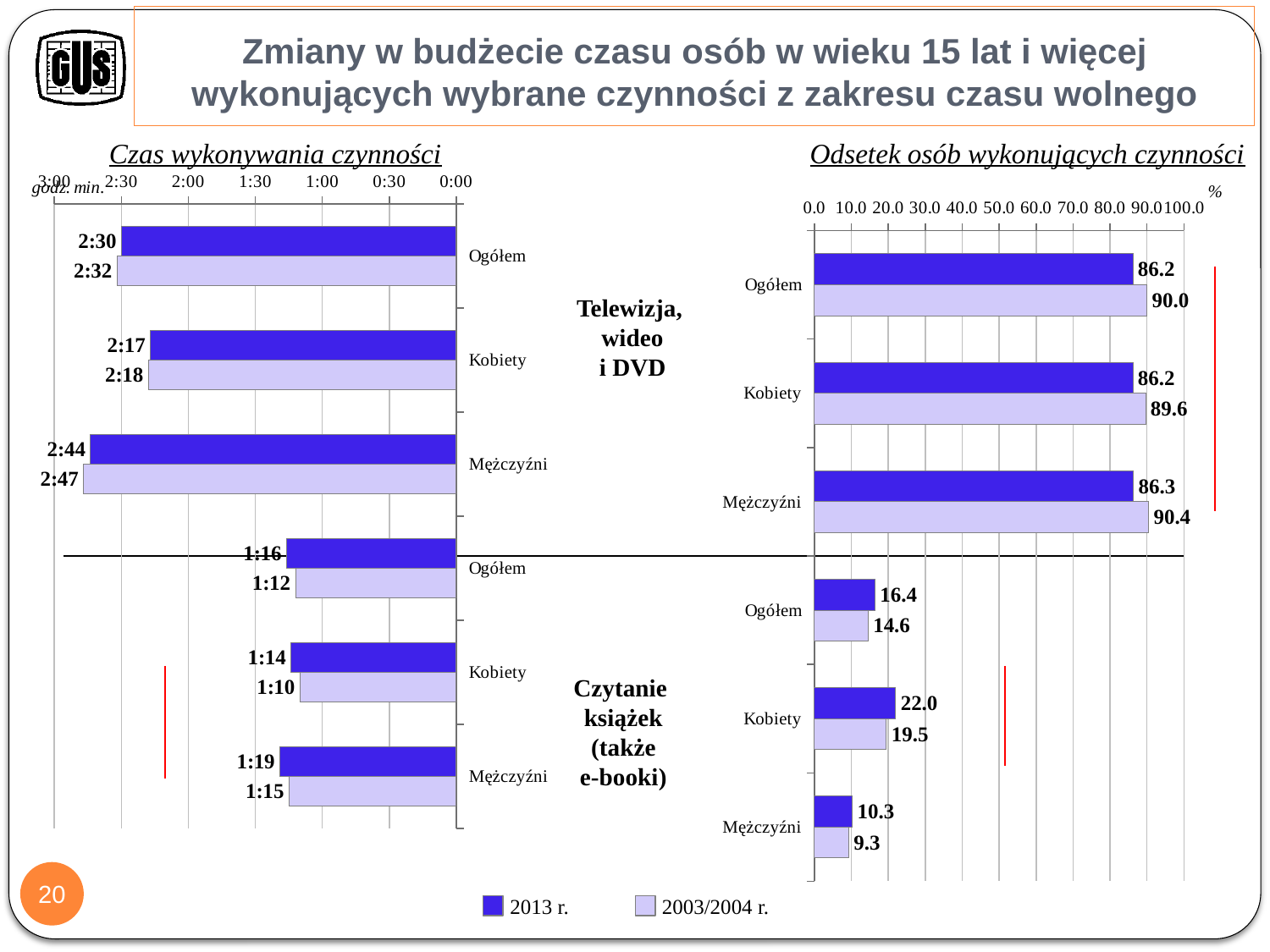
In the chart 'Odsetek osób wykonujących czynności', what is the 2003/2004 r. value for Mężczyźni for Czytanie książek (także e-booki)? 9.3 In the chart 'Odsetek osób wykonujących czynności', what is the difference between the 2013 r. and 2003/2004 r. values for Kobiety for Czytanie książek (także e-booki)? 2.5 In the chart 'Odsetek osób wykonujących czynności', what is the 2013 r. value for Ogółem for Telewizja, wideo i DVD? 86.2 How many series does the legend at the bottom of the slide list? 2 In the chart 'Odsetek osób wykonujących czynności', is the 2013 r. value for Ogółem for Czytanie książek (także e-booki) greater or less than 20.0? less What kind of chart is 'Czas wykonywania czynności'? bar chart In the chart 'Czas wykonywania czynności', what is the 2003/2004 r. value for Kobiety for Czytanie książek (także e-booki)? 1:10 In the chart 'Odsetek osób wykonujących czynności', what is the difference between the 2003/2004 r. and 2013 r. values for Ogółem for Telewizja, wideo i DVD? 3.8 In the chart 'Czas wykonywania czynności', what is the 2013 r. value for Mężczyźni for Telewizja, wideo i DVD? 2:44 In the chart 'Odsetek osób wykonujących czynności', which category has the highest 2013 r. value for Czytanie książek (także e-booki)? Kobiety In the chart 'Odsetek osób wykonujących czynności', which is larger for Mężczyźni for Telewizja, wideo i DVD: the 2013 r. value or the 2003/2004 r. value? 2003/2004 r. In the chart 'Odsetek osób wykonujących czynności', which category has the lowest 2003/2004 r. value for Czytanie książek (także e-booki)? Mężczyźni